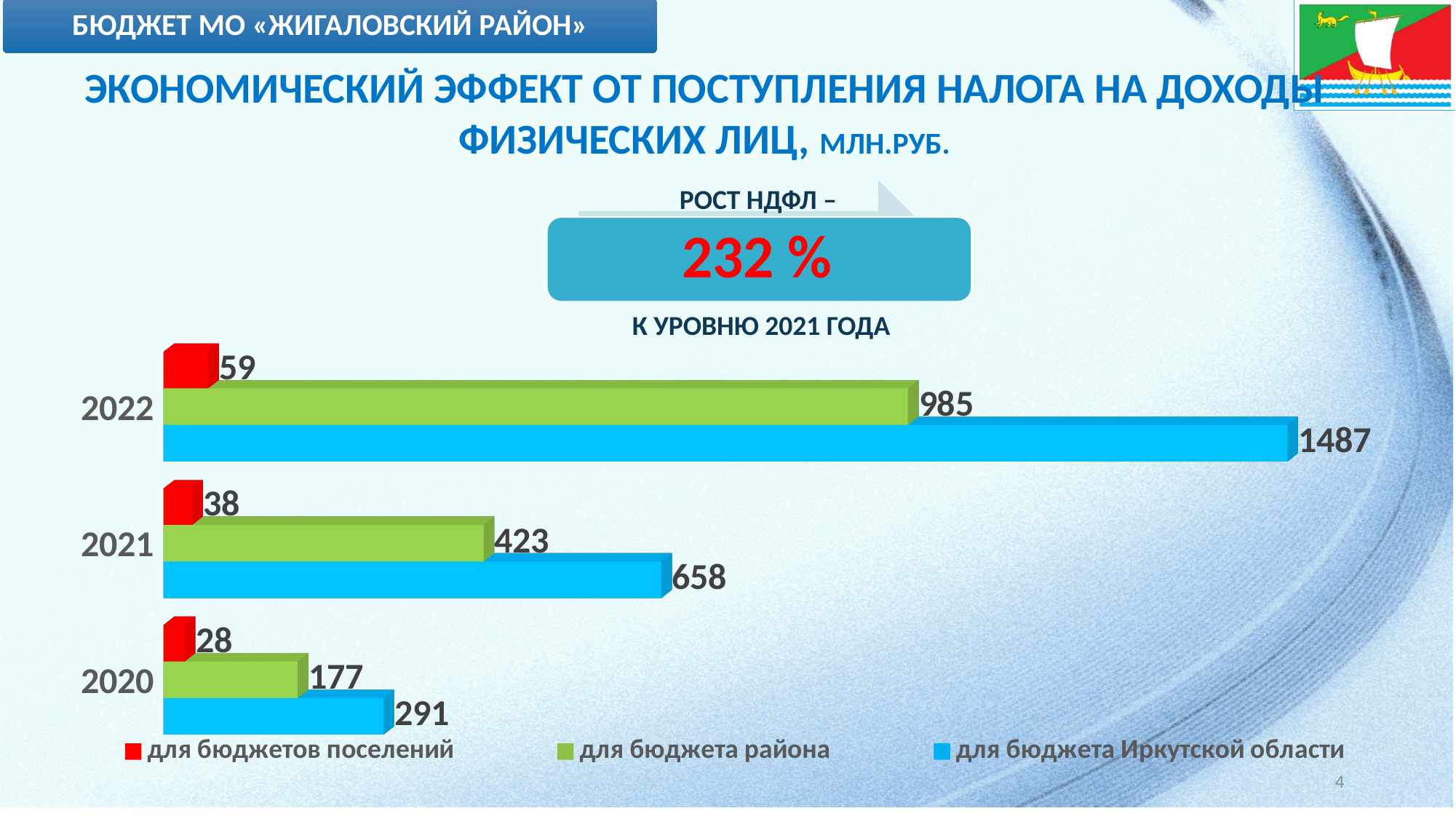
How many years (categories) are shown on the chart? 3 How many series does the legend list? 3 Which year has the lowest value for "для бюджета Иркутской области"? 2020 What is the difference between the "для бюджета Иркутской области" values for 2022 and 2021? 829 Do the values for "для бюджета Иркутской области" rise or fall from 2020 to 2022? Rise What is the difference between the "для бюджетов поселений" values for 2021 and 2020? 10 What is the value for "для бюджета Иркутской области" in 2022? 1487 Which is larger: the "для бюджета района" value in 2022 or the "для бюджета Иркутской области" value in 2021? для бюджета района in 2022 What kind of chart is shown on the slide? Bar chart What is the value for "для бюджета района" in 2021? 423 Which year has the highest value for "для бюджета района"? 2022 What is the value for "для бюджетов поселений" in 2020? 28